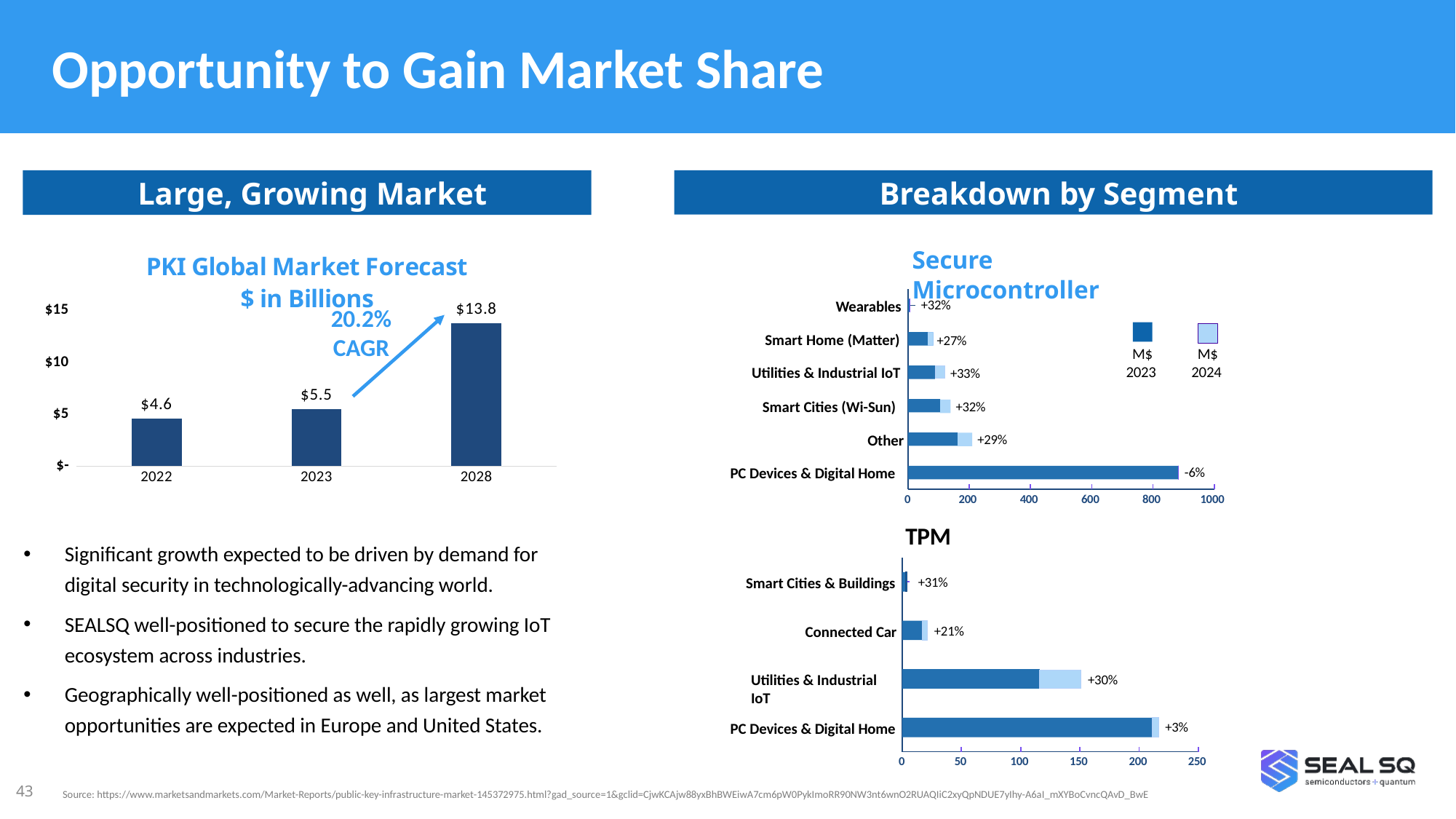
In the Secure Microcontroller chart, how many segments are listed? 6 In the TPM chart, what growth percentage is shown for Utilities & Industrial IoT? +30% In the TPM chart, which segment has the longest bar? PC Devices & Digital Home In the PKI Global Market Forecast chart, do the values rise or fall from 2022 to 2028? rise In the Secure Microcontroller chart, how many series does the legend list? 2 What kind of chart is the PKI Global Market Forecast chart? bar chart In the PKI Global Market Forecast chart, what is the value for 2028? $13.8 In the Secure Microcontroller chart, is the M$ 2023 value for PC Devices & Digital Home greater or less than 800? greater In the Secure Microcontroller chart, what growth percentage is shown for PC Devices & Digital Home? -6% In the PKI Global Market Forecast chart, what is the value for 2022? $4.6 In the PKI Global Market Forecast chart, how many years are plotted? 3 In the PKI Global Market Forecast chart, what is the difference between the 2028 and 2023 values? $8.3